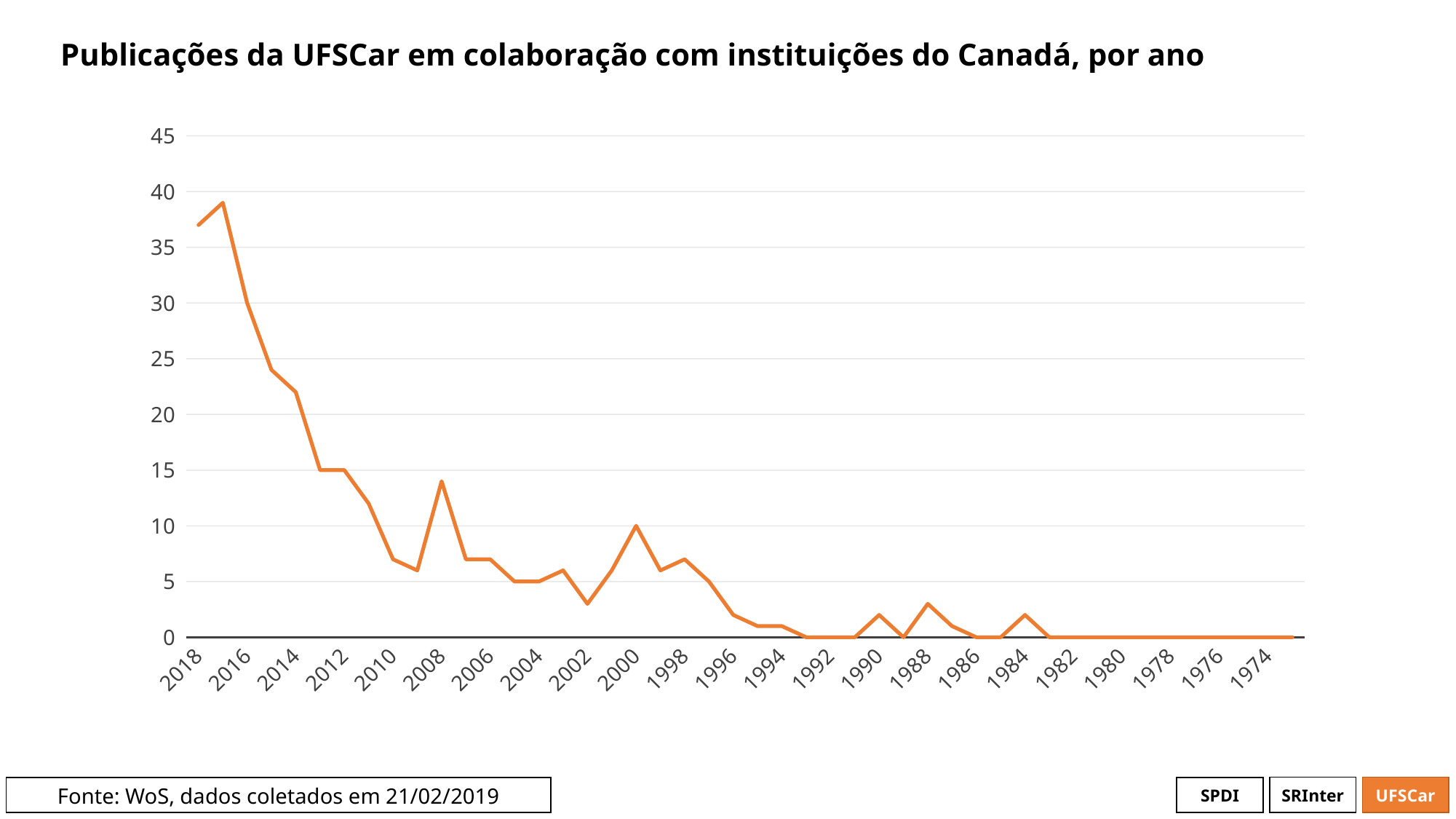
What is the value for 2004? 5 Is the value for 2002 greater or less than 5? less What kind of chart is shown on the slide? line chart What is the value for 2012? 15 Which is larger, the value for 2018 or the value for 2016? 2018 What is the title of the chart? Publicações da UFSCar em colaboração com instituições do Canadá, por ano Is the value for 2018 greater or less than 35? greater Moving from left (2018) to right (1974) along the x axis, do the values generally rise or fall? fall What is the value for 1974? 0 Is the value for 2014 greater or less than 20? greater Which is larger, the value for 2008 or the value for 2006? 2008 What is the value for 2000? 10